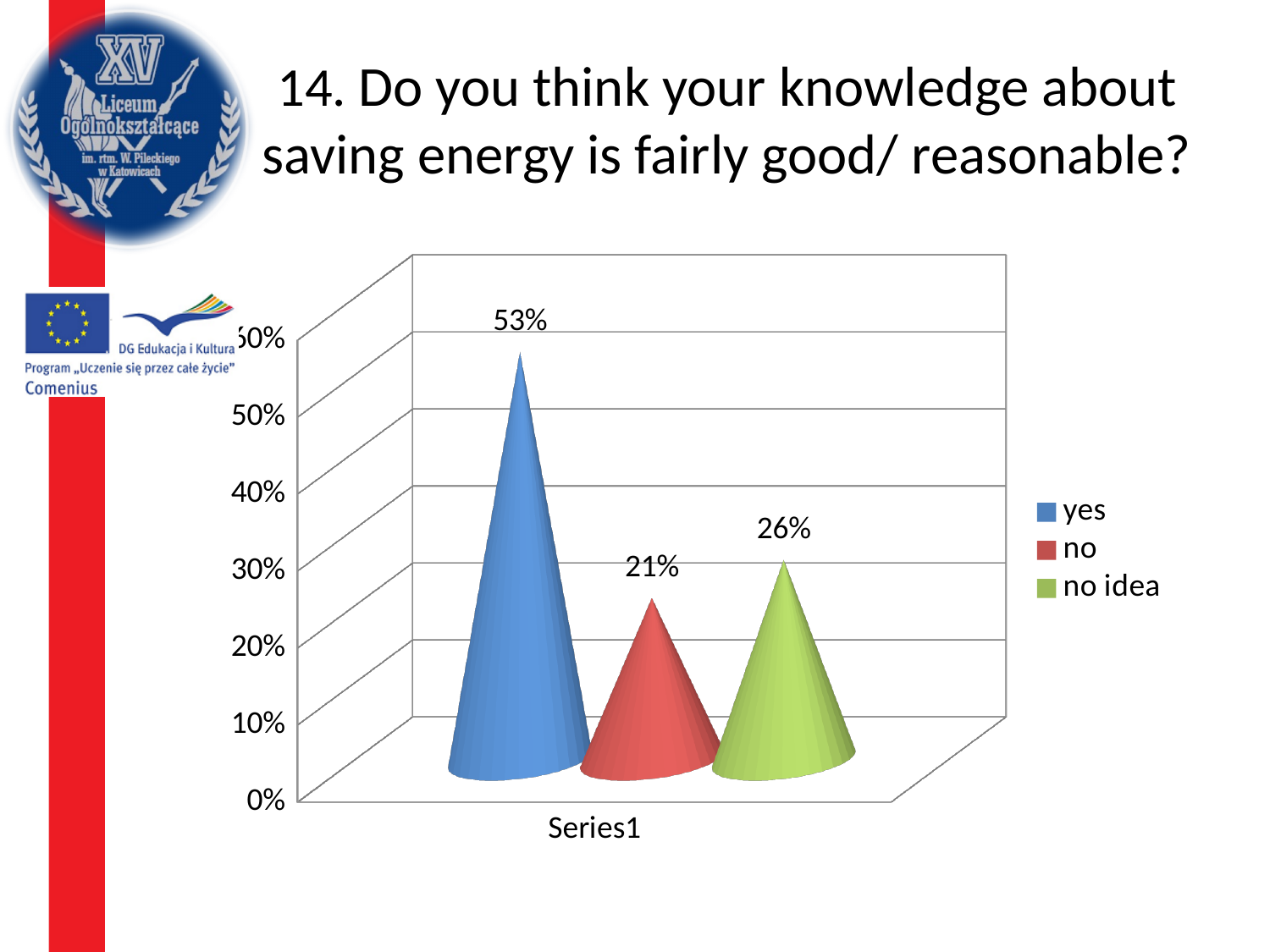
What percentage of respondents answered "no idea"? 26% What is the difference in percentage points between "yes" and "no"? 32 Which response has the highest percentage? yes Which response has the lowest percentage? no What is the difference in percentage points between "no idea" and "no"? 5 How many response categories are shown in the chart? 3 Is the value for "yes" greater or less than 50%? greater How many entries does the legend list? 3 What colour represents the "no idea" response in the chart? green What percentage of respondents answered "no"? 21% What percentage of respondents answered "yes"? 53% Which is larger, the value for "no idea" or the value for "no"? no idea